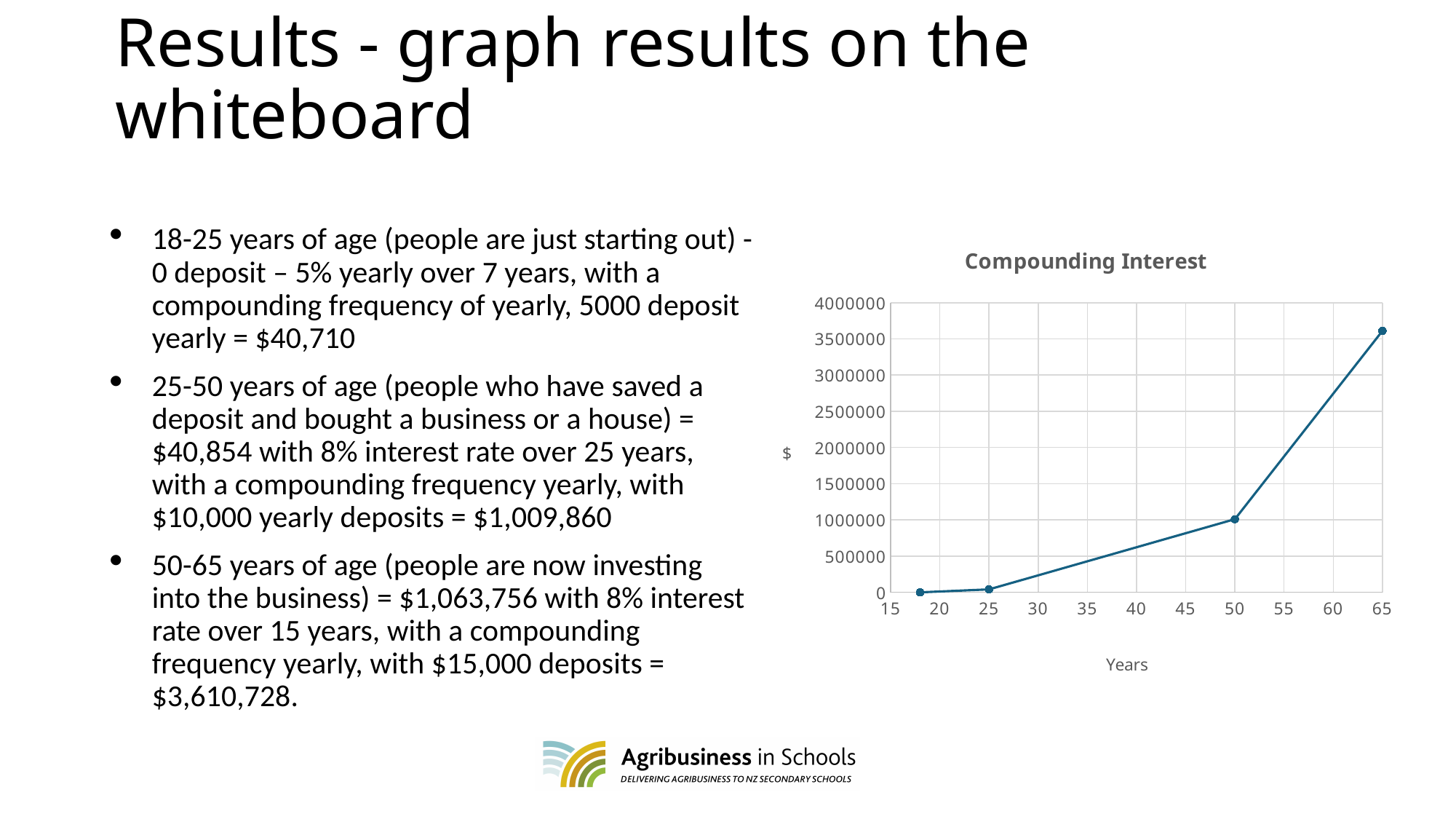
Is the value at 50 years greater or less than 1500000? less What is the highest tick value shown on the y axis? 4000000 At which year on the x axis does the line reach its highest value? 65 Is the value at 65 years greater or less than 3000000? greater Is the value at 25 years greater or less than 500000? less What is the title of the chart? Compounding Interest Do the values rise or fall as the years increase along the x axis? rise What is the label on the x axis of the chart? Years What kind of chart is shown on the slide? line chart How many data points are plotted on the line? 4 Which is larger, the value at 50 years or the value at 65 years? 65 years